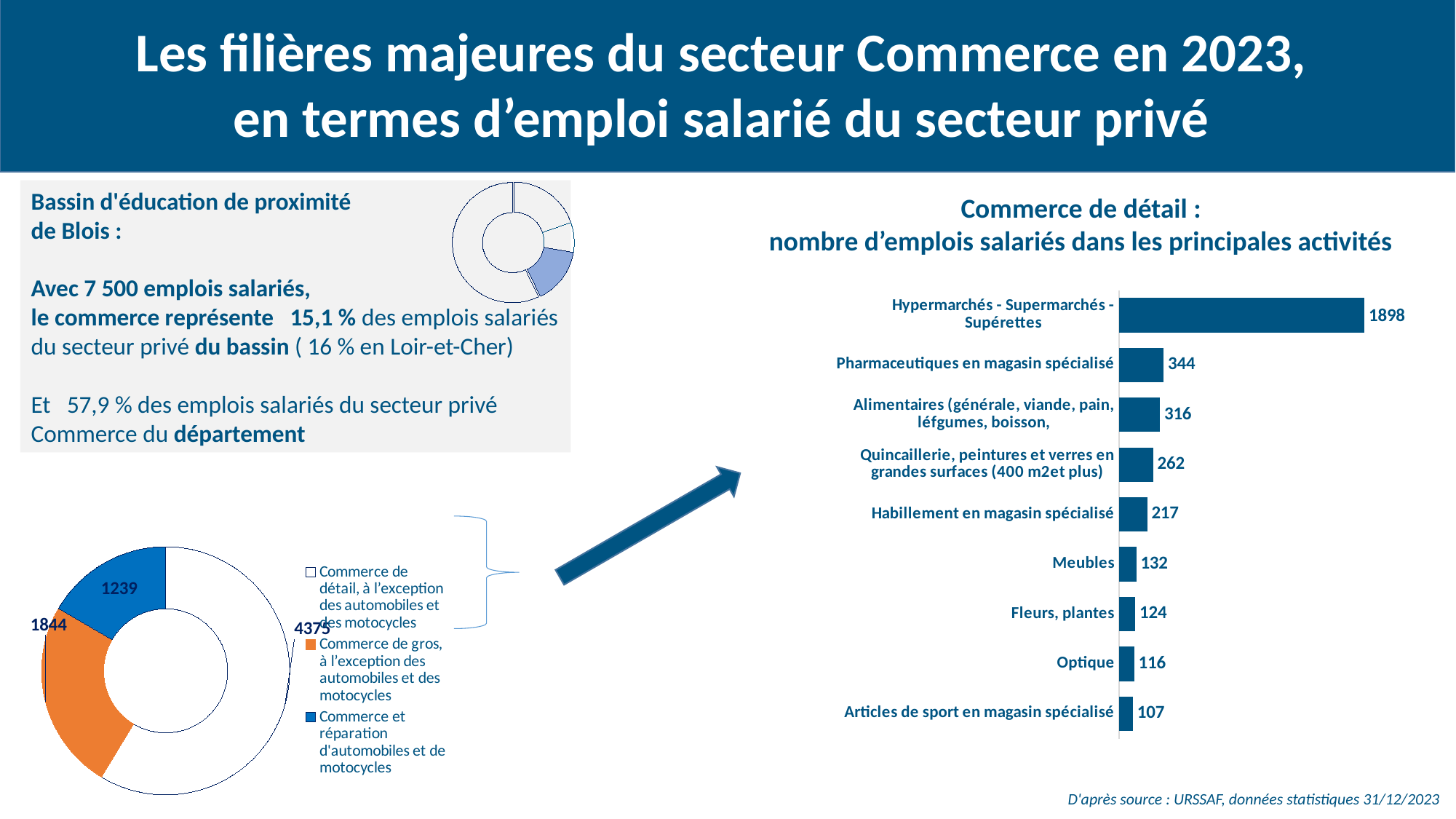
In the donut chart at the bottom left, what is the value for Commerce de gros, à l'exception des automobiles et des motocycles? 1844 In the bar chart 'Commerce de détail', which activity has the highest number of salaried jobs? Hypermarchés - Supermarchés - Supérettes How many activities are listed in the bar chart 'Commerce de détail'? 9 What kind of chart is the chart on the right of the slide? Bar chart In the bar chart 'Commerce de détail', which is larger: Fleurs, plantes or Optique? Fleurs, plantes In the bar chart 'Commerce de détail', what is the value for Meubles? 132 In the bar chart 'Commerce de détail', what is the value for Pharmaceutiques en magasin spécialisé? 344 In the bar chart 'Commerce de détail', how many salaried jobs are shown for Hypermarchés - Supermarchés - Supérettes? 1898 How many entries does the legend of the donut chart at the bottom left list? 3 In the bar chart 'Commerce de détail', what is the difference between Hypermarchés - Supermarchés - Supérettes and Pharmaceutiques en magasin spécialisé? 1554 In the bar chart 'Commerce de détail', which activity has the lowest number of salaried jobs? Articles de sport en magasin spécialisé In the donut chart at the bottom left, what is the difference between Commerce de détail (4375) and Commerce et réparation d'automobiles et de motocycles (1239)? 3136